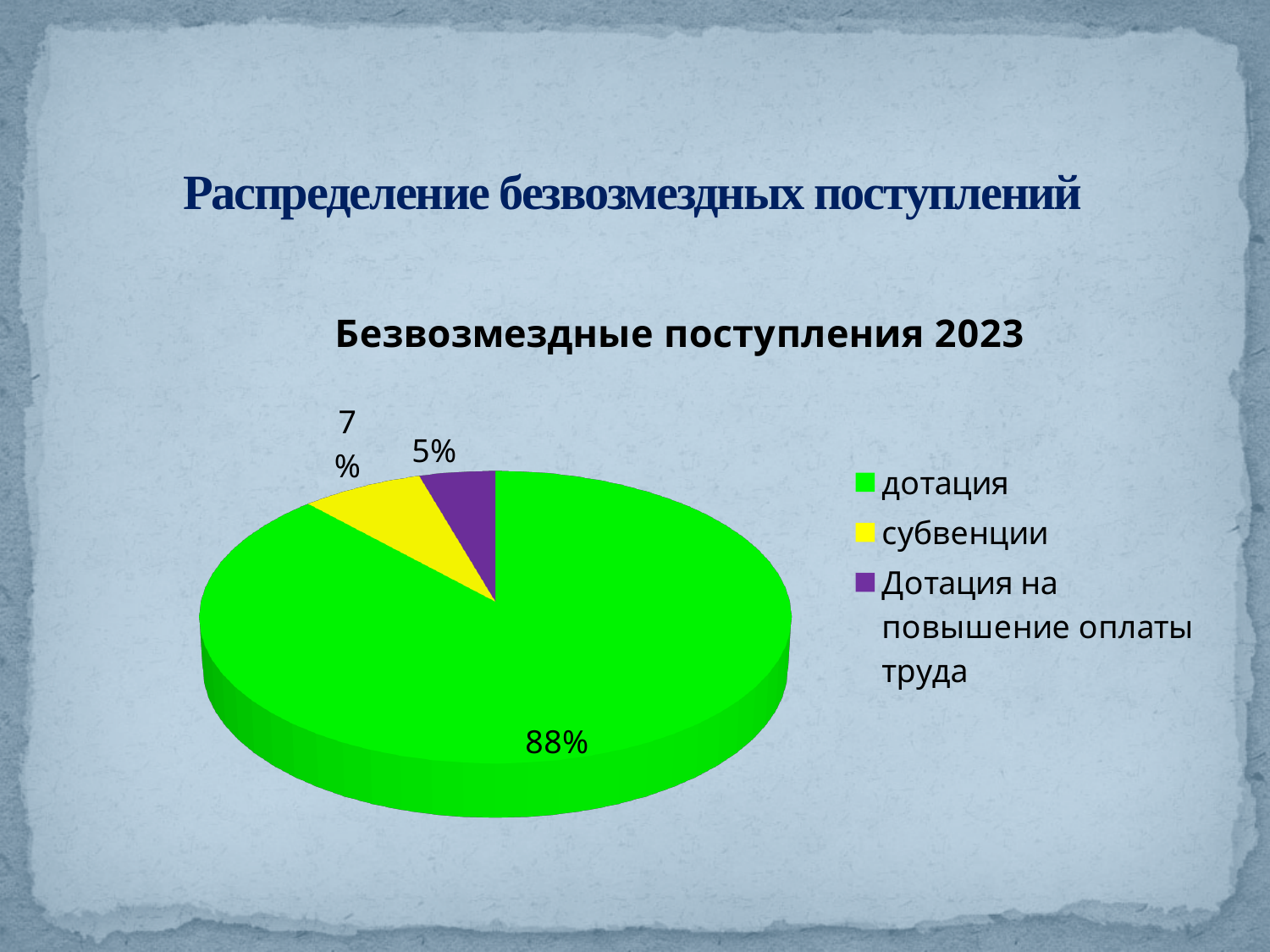
What share of the pie does субвенции have? 7% What is the title of the chart? Безвозмездные поступления 2023 What type of chart is shown on the slide? Pie chart What colour represents субвенции in the chart? Yellow What share of the pie does дотация have? 88% What is the difference in percentage points between дотация and субвенции? 81 Which category has the smallest share of the pie? Дотация на повышение оплаты труда What share of the pie does Дотация на повышение оплаты труда have? 5% Which category has the largest share of the pie? дотация How many categories does the pie chart show? 3 Which is larger, the share for субвенции or the share for Дотация на повышение оплаты труда? субвенции How many entries does the legend list? 3